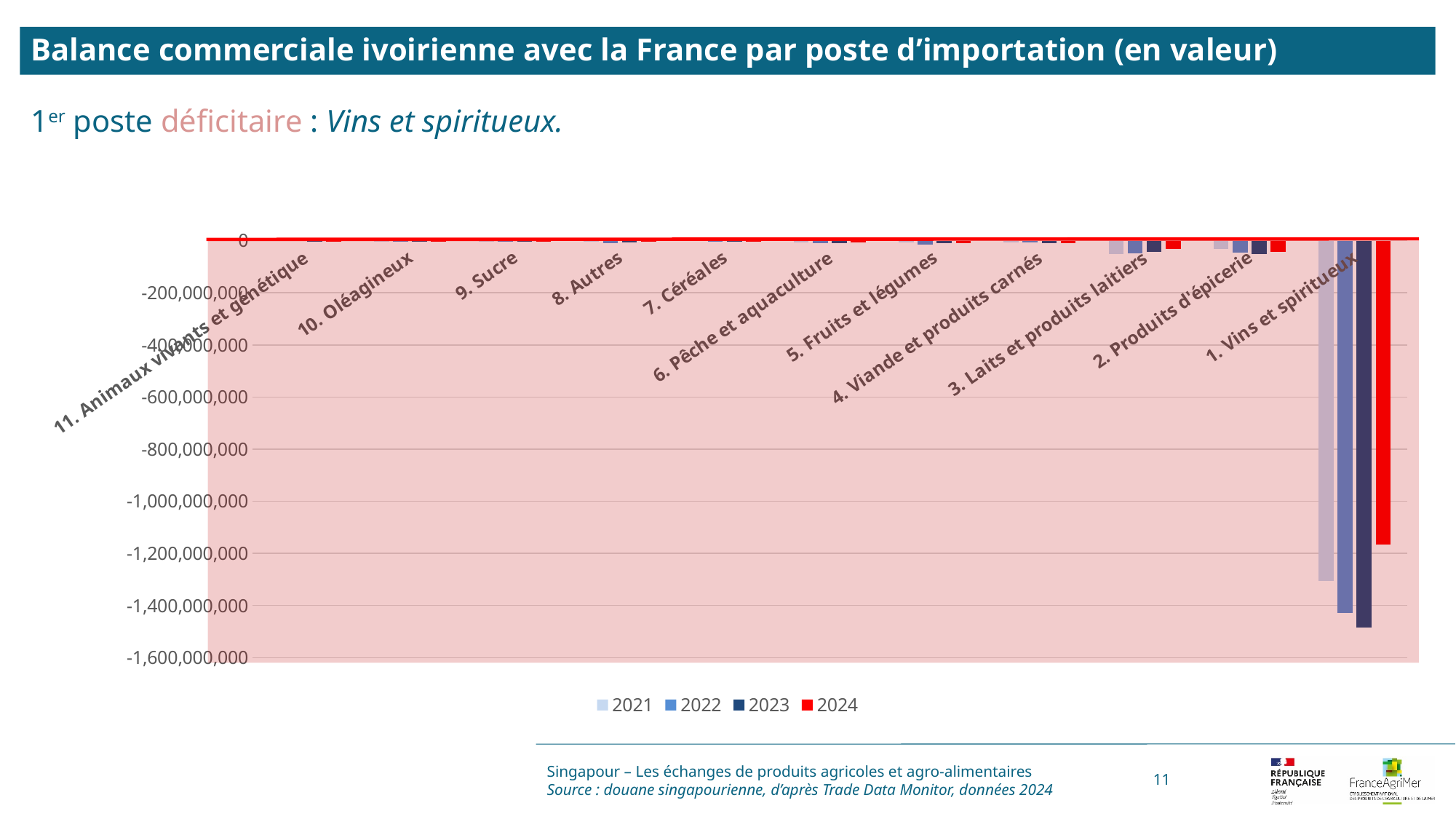
Which years are listed in the chart legend? 2021, 2022, 2023, 2024 What colour represents the 2024 series in the chart? red What kind of chart is shown on the slide? bar chart For 1. Vins et spiritueux, which is larger, the 2023 value or the 2024 value? 2024 How many import categories are shown on the x axis of the chart? 11 Is the 2021 value for 1. Vins et spiritueux greater or less than -1,200,000,000? less How many series does the chart legend list? 4 Which category shows the largest deficit (most negative values) in the chart? 1. Vins et spiritueux For 1. Vins et spiritueux, which year has the lowest (most negative) value? 2023 Is the 2023 value for 1. Vins et spiritueux greater or less than -1,400,000,000? less Is the 2024 value for 1. Vins et spiritueux greater or less than -1,000,000,000? less